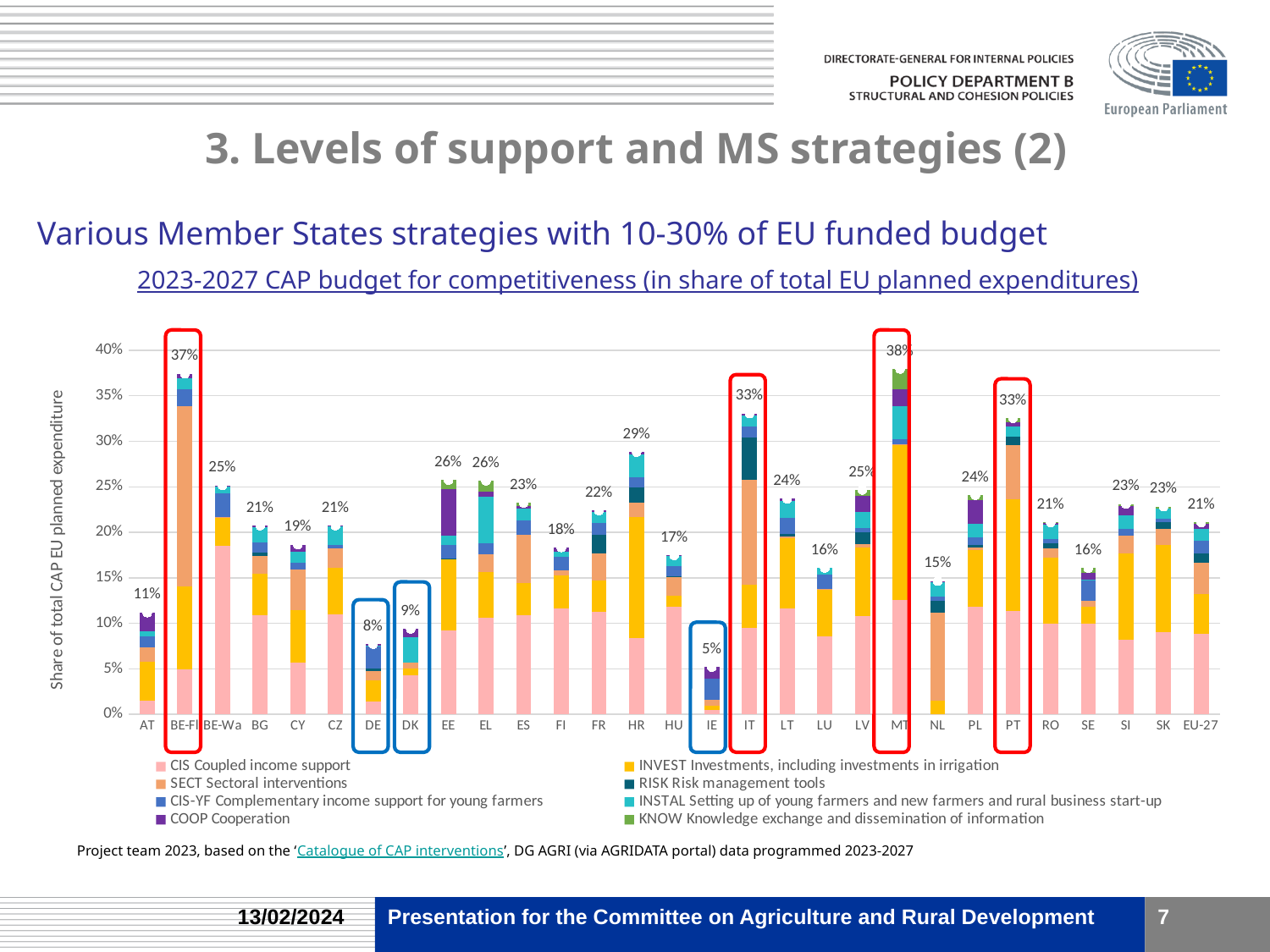
What is the title of the chart? 2023-2027 CAP budget for competitiveness (in share of total EU planned expenditures) What kind of chart is shown on the slide? Stacked bar chart What is the total share shown for EU-27? 21% Is the total share for PT greater or less than 30%? greater What is the total share shown for IE? 5% Which has a larger total share, HR or FR? HR Which Member State has the highest total share of CAP EU planned expenditure for competitiveness? MT How many series does the legend list? 8 How many Member State/aggregate categories are shown on the x axis? 29 Which Member State has the lowest total share of CAP EU planned expenditure for competitiveness? IE What is the total share of CAP EU planned expenditure for competitiveness shown for MT? 38% What is the difference between the total share for BE-Fl and the total share for DE? 29%